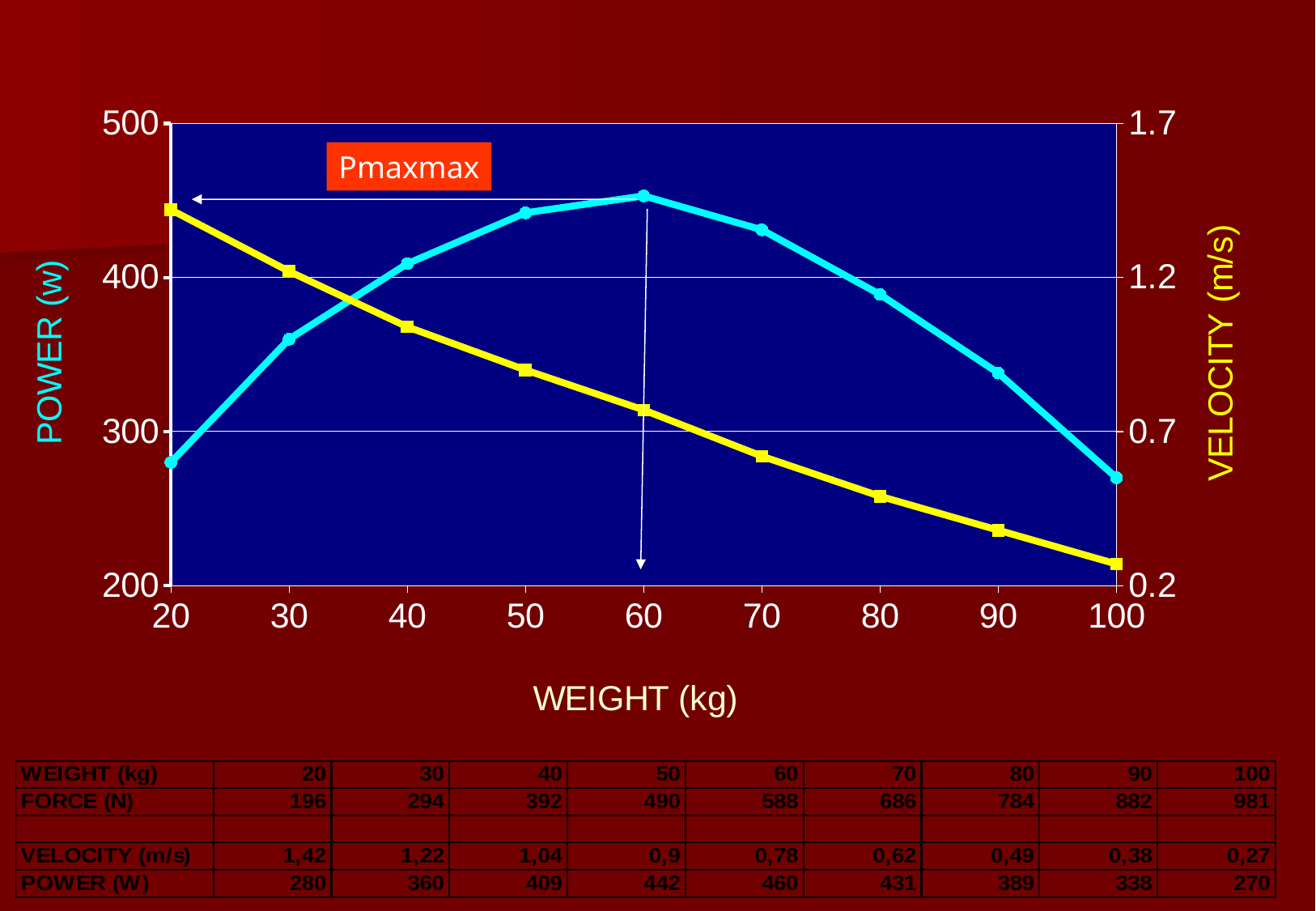
At which weight is the POWER value lowest? 100 kg Which is larger, the POWER at 30 kg or the POWER at 90 kg? POWER at 30 kg Is the POWER value at 20 kg greater or less than 300? less Does the VELOCITY series rise or fall as weight increases along the x axis? fall What is the POWER value at a weight of 40 kg? 409 At which weight does the POWER series reach its highest value? 60 kg What is the difference between the POWER at 60 kg and the POWER at 20 kg? 180 What kind of chart is shown on the slide? line chart What text is written in the red box on the chart? Pmaxmax What is the VELOCITY value at a weight of 50 kg? 0,9 How many weight values are plotted along the x axis of the chart? 9 What is the highest VELOCITY value shown, and at which weight does it occur? 1,42 at 20 kg